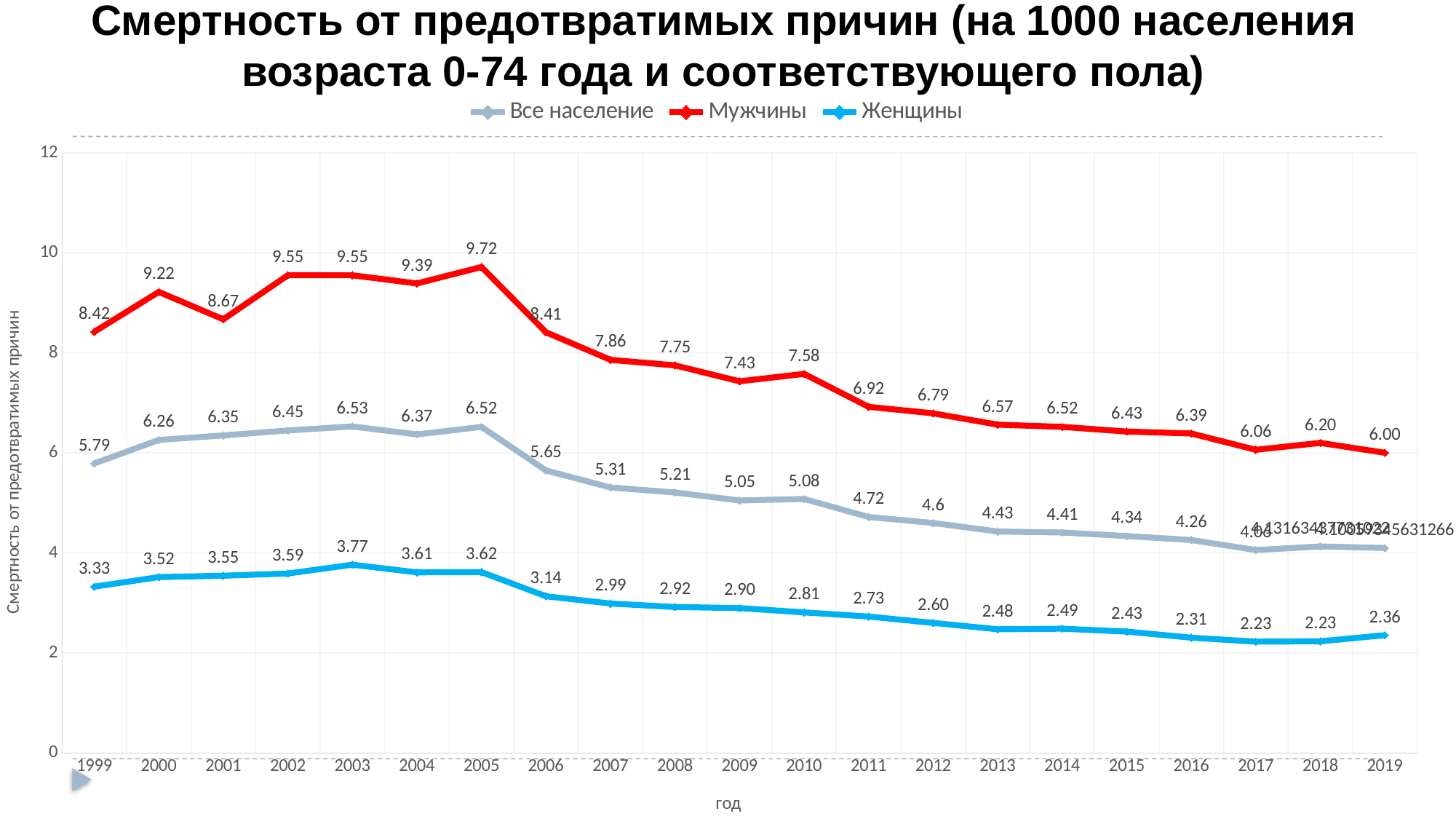
In which year is the value for Женщины highest? 2003 What is the value for Все население in 2006? 5.65 In which year is the value for Мужчины highest? 2005 What is the difference between the Мужчины and Женщины values in 1999? 5.09 What kind of chart is shown on the slide? line chart Which is larger: the Мужчины value in 2010 or in 2009? 2010 How many years are shown on the x axis? 21 How many series does the legend list? 3 What is the value for Женщины in 2003? 3.77 What is the value for Мужчины in 2005? 9.72 What is the difference between the Мужчины values in 2005 and 2019? 3.72 Is the value for Мужчины in 2003 greater or less than 10? less